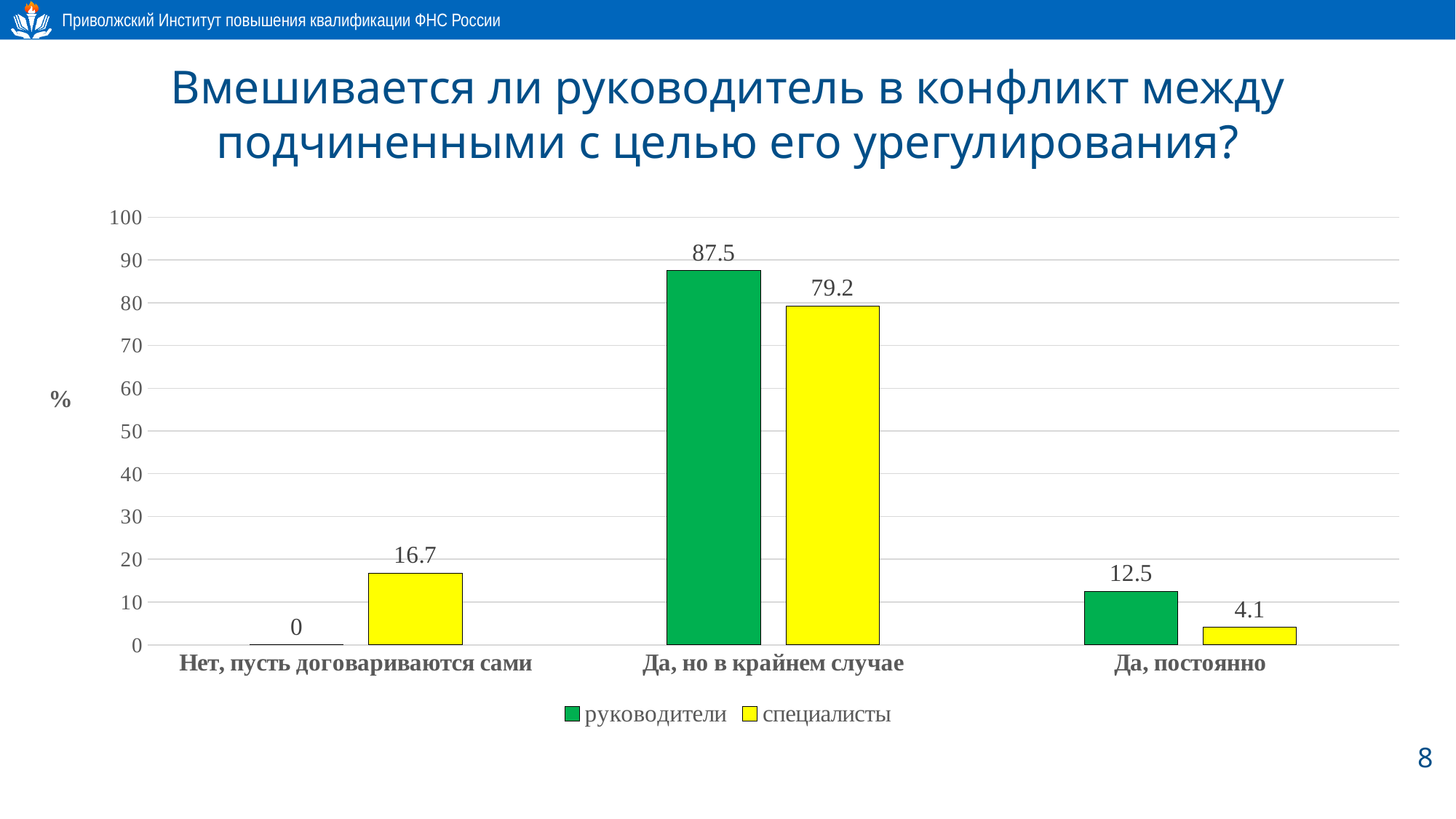
What value is shown for руководители in the category "Да, но в крайнем случае"? 87.5 How many series does the legend list? 2 What value is shown for специалисты in the category "Да, постоянно"? 4.1 What colour are the bars for специалисты? yellow What value is shown for специалисты in the category "Нет, пусть договариваются сами"? 16.7 Which category has the highest value for специалисты? Да, но в крайнем случае What kind of chart is shown on the slide? bar chart What is the difference between руководители and специалисты in the category "Да, но в крайнем случае"? 8.3 Which category has the lowest value for руководители? Нет, пусть договариваются сами In the category "Да, постоянно", which series has the larger value, руководители or специалисты? руководители What value is shown for руководители in the category "Нет, пусть договариваются сами"? 0 How many categories are shown on the x axis? 3